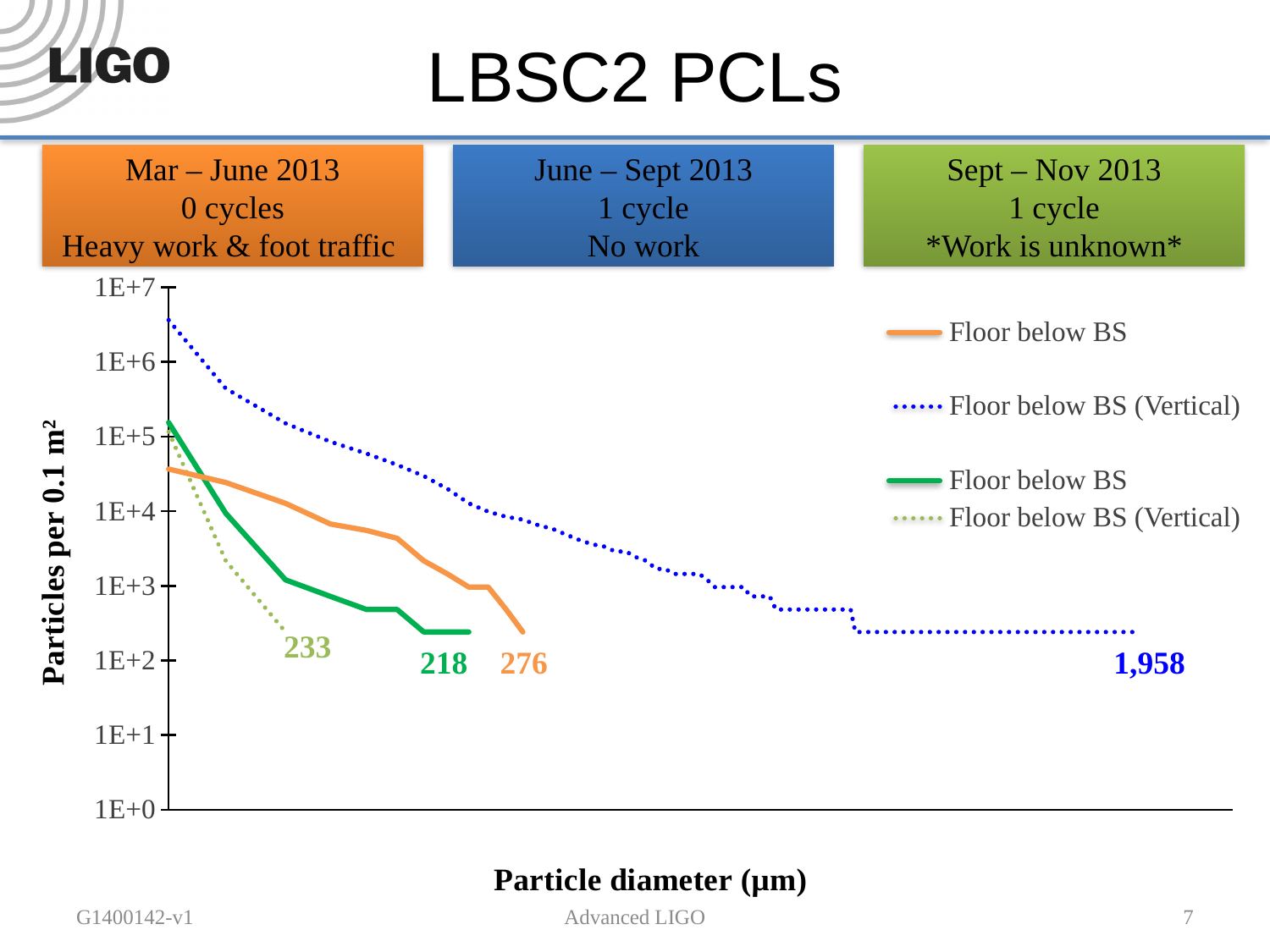
What is the label on the y axis? Particles per 0.1 m² Do the plotted values rise or fall as particle diameter increases along the x axis? fall What value is printed at the end of the green dotted Floor below BS (Vertical) line? 233 Is the starting value of the blue dotted Floor below BS (Vertical) line greater or less than 1E+6? greater How many series does the legend list? 4 What kind of chart is shown on the slide? line chart What value is printed at the end of the solid green Floor below BS line? 218 Which of the four printed end-of-line values is the largest? 1,958 What value is printed at the end of the blue dotted Floor below BS (Vertical) line? 1,958 What is the difference between the printed end values of the orange line (276) and the solid green line (218)? 58 What value is printed at the end of the orange Floor below BS line? 276 What is the label on the x axis? Particle diameter (µm)